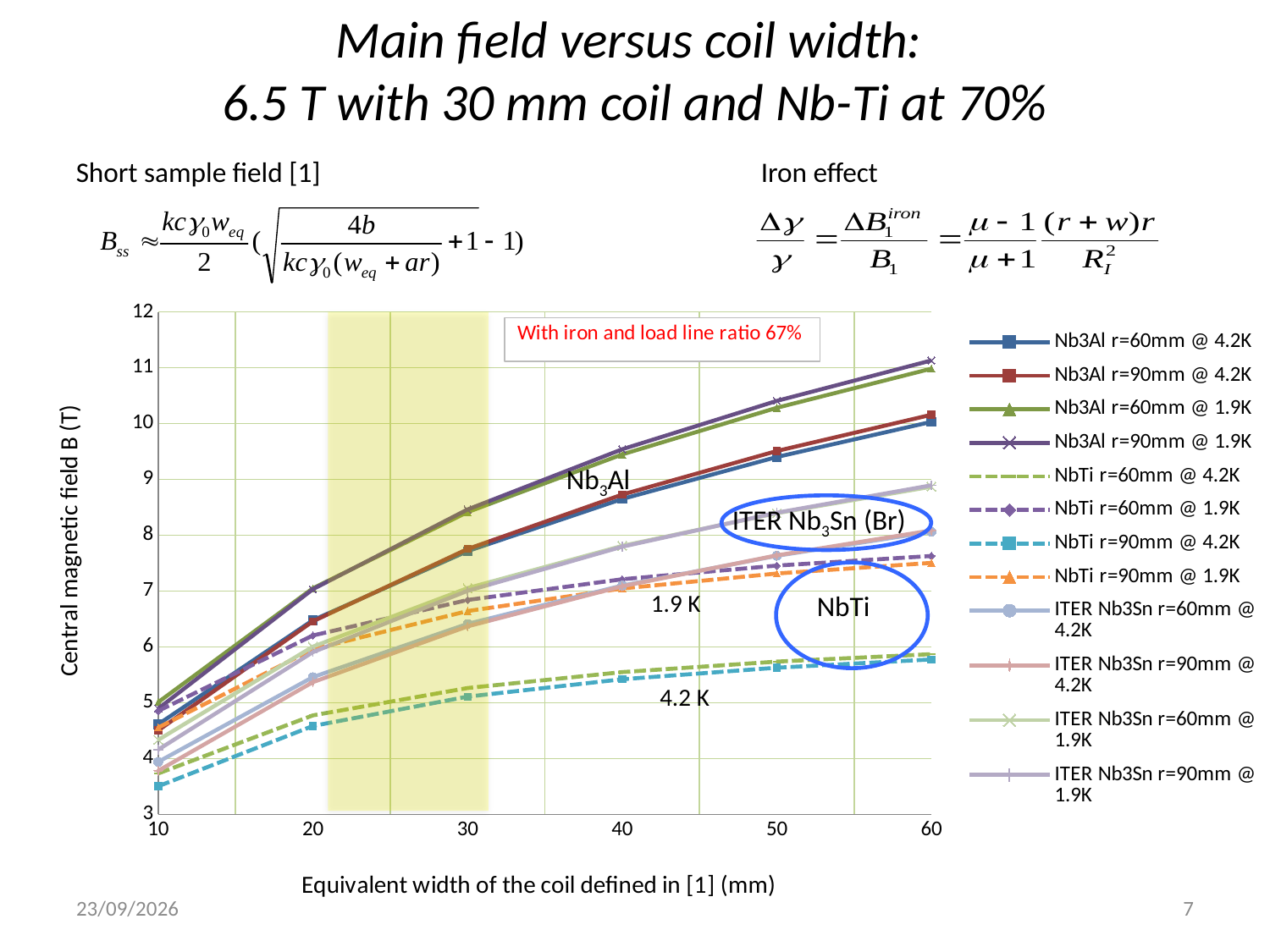
How many coil-width points are plotted along the x axis for each series? 6 Do the central magnetic field values rise or fall as the equivalent coil width increases? rise What kind of chart is shown on the slide? line chart At 40 mm coil width, which is larger: Nb3Al r=60mm @ 4.2K or ITER Nb3Sn r=60mm @ 4.2K? Nb3Al r=60mm @ 4.2K Is the value for Nb3Al r=60mm @ 4.2K at 30 mm greater or less than 7? greater Is the value for NbTi r=60mm @ 1.9K at 60 mm greater or less than 8? less Is the value for NbTi r=90mm @ 4.2K at 10 mm greater or less than 4? less How many series does the chart legend list? 12 What is the title of the x axis of the chart? Equivalent width of the coil defined in [1] (mm) What is the title of the y axis of the chart? Central magnetic field B (T) Which series has the lowest central magnetic field at 10 mm coil width? NbTi r=90mm @ 4.2K